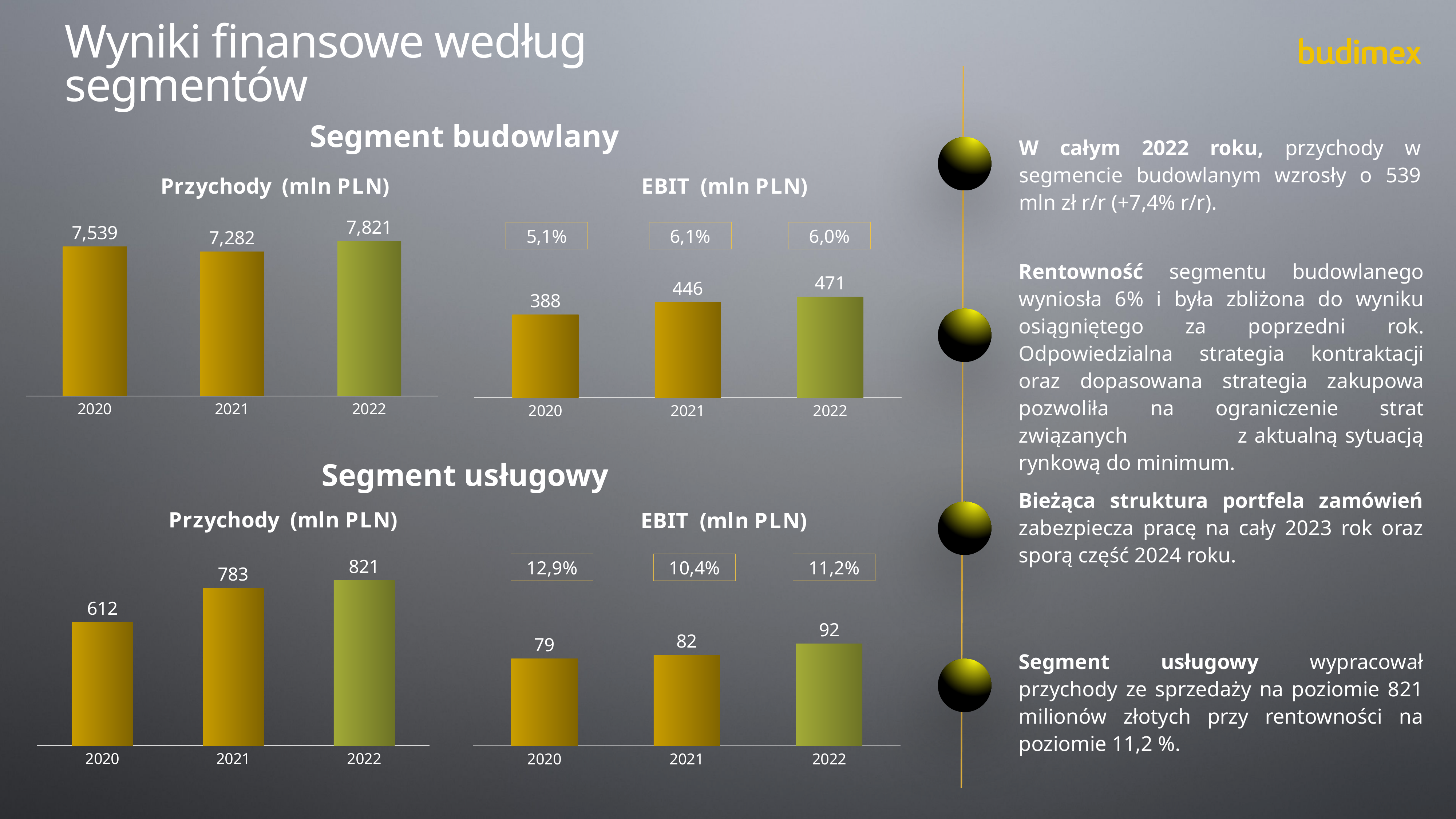
In the Segment usługowy Przychody (mln PLN) chart, what is the difference between the 2021 and 2020 values? 171 How many bars are in the Segment budowlany Przychody (mln PLN) chart? 3 In the Segment budowlany EBIT (mln PLN) chart, what is the difference between the 2022 and 2021 values? 25 In the Segment usługowy Przychody (mln PLN) chart, what is the value for 2020? 612 In the Segment budowlany Przychody (mln PLN) chart, what is the value for 2022? 7,821 In the Segment budowlany EBIT (mln PLN) chart, what is the value for 2020? 388 In the Segment usługowy EBIT (mln PLN) chart, which year has the highest value? 2022 In the Segment budowlany Przychody (mln PLN) chart, which year has the lowest value? 2021 In the Segment usługowy Przychody (mln PLN) chart, do the values rise or fall from 2020 to 2022? rise In the Segment budowlany EBIT (mln PLN) chart, what percentage is shown above the 2021 bar? 6,1% What type of chart is the Segment usługowy EBIT (mln PLN) chart? bar chart In the Segment usługowy EBIT (mln PLN) chart, what percentage is shown above the 2020 bar? 12,9%